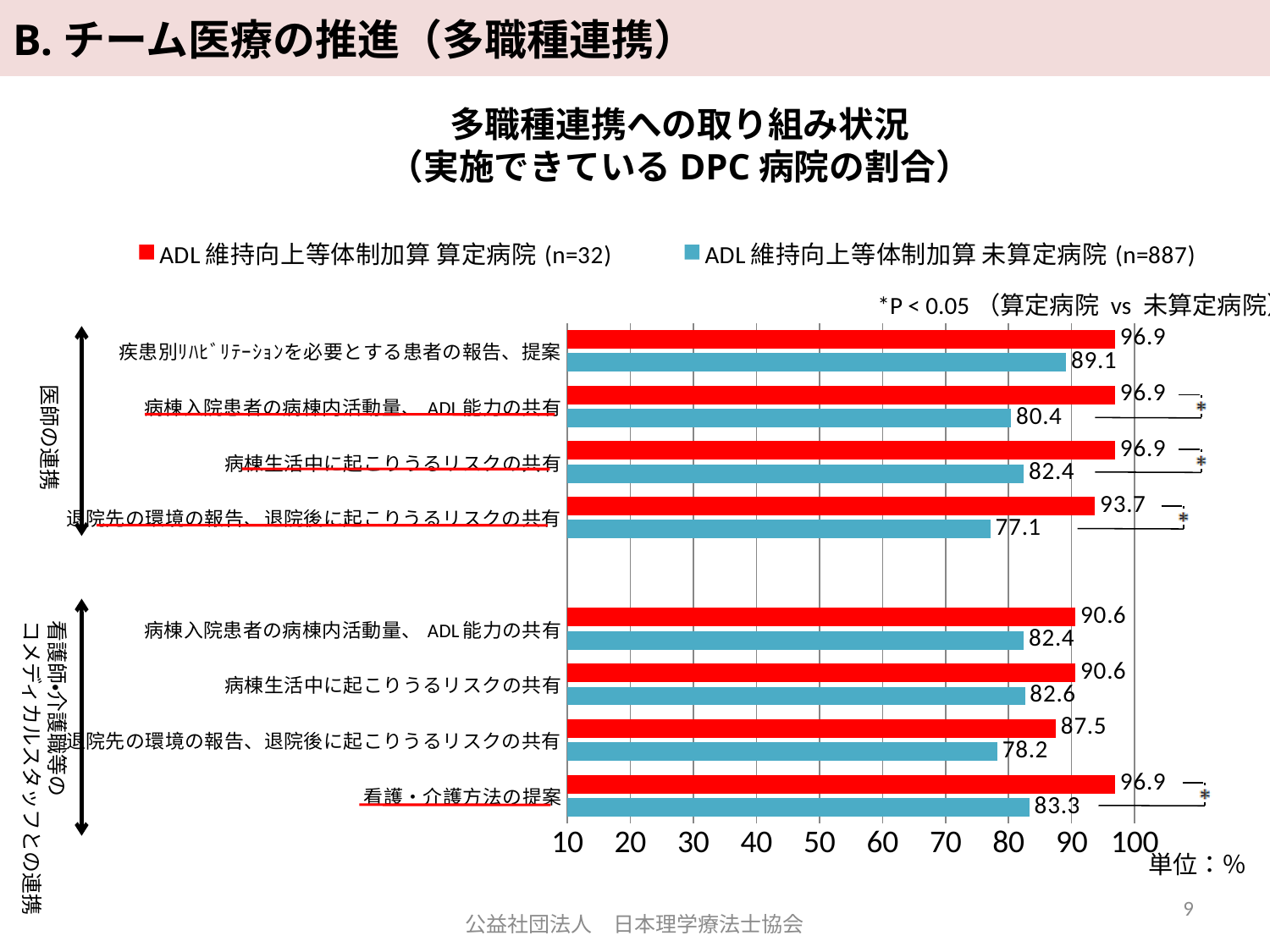
For 看護・介護方法の提案, which series has the larger value, 算定病院 or 未算定病院? 算定病院 Which category has the lowest value for 算定病院? 退院先の環境の報告、退院後に起こりうるリスクの共有 (看護師・介護職等) What is the sample size (n) of ADL維持向上等体制加算 未算定病院 shown in the legend? 887 What is the value for 未算定病院 for 看護・介護方法の提案? 83.3 In the 医師の連携 group, what is the difference between 算定病院 and 未算定病院 for 病棟入院患者の病棟内活動量、ADL能力の共有? 16.5 How many series does the legend list? 2 What type of chart is shown on the slide? bar chart Which category has the lowest value for 未算定病院? 退院先の環境の報告、退院後に起こりうるリスクの共有 (医師の連携) How many categories (items) are plotted in the chart? 8 What is the value for ADL維持向上等体制加算 未算定病院 for 疾患別リハビリテーションを必要とする患者の報告、提案? 89.1 In the 医師の連携 group, what is the value for 未算定病院 for 退院先の環境の報告、退院後に起こりうるリスクの共有? 77.1 What is the value for ADL維持向上等体制加算 算定病院 for 疾患別リハビリテーションを必要とする患者の報告、提案? 96.9